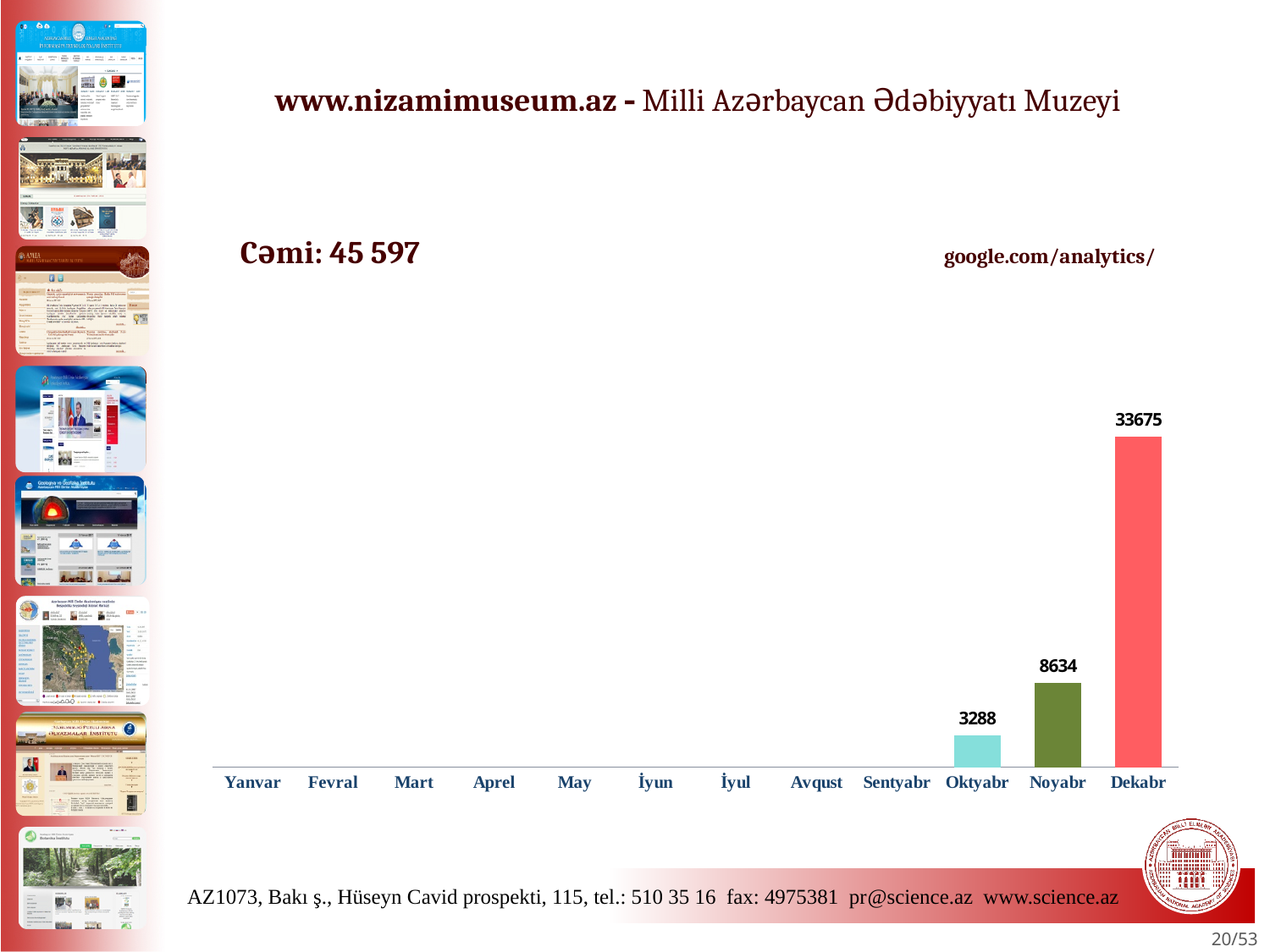
What total (Cəmi) is stated on the slide? 45 597 How many months have a visible bar in the chart? 3 Among the months with a bar shown, which has the lowest value? Oktyabr What kind of chart is shown on the slide? bar chart Which is larger, the value for Noyabr or the value for Oktyabr? Noyabr What is the difference between the values for Dekabr and Noyabr? 25041 What is the difference between the values for Noyabr and Oktyabr? 5346 How many month categories are shown on the x axis? 12 What is the value for Noyabr? 8634 Which month has the highest value? Dekabr What is the value for Dekabr? 33675 What is the value for Oktyabr? 3288